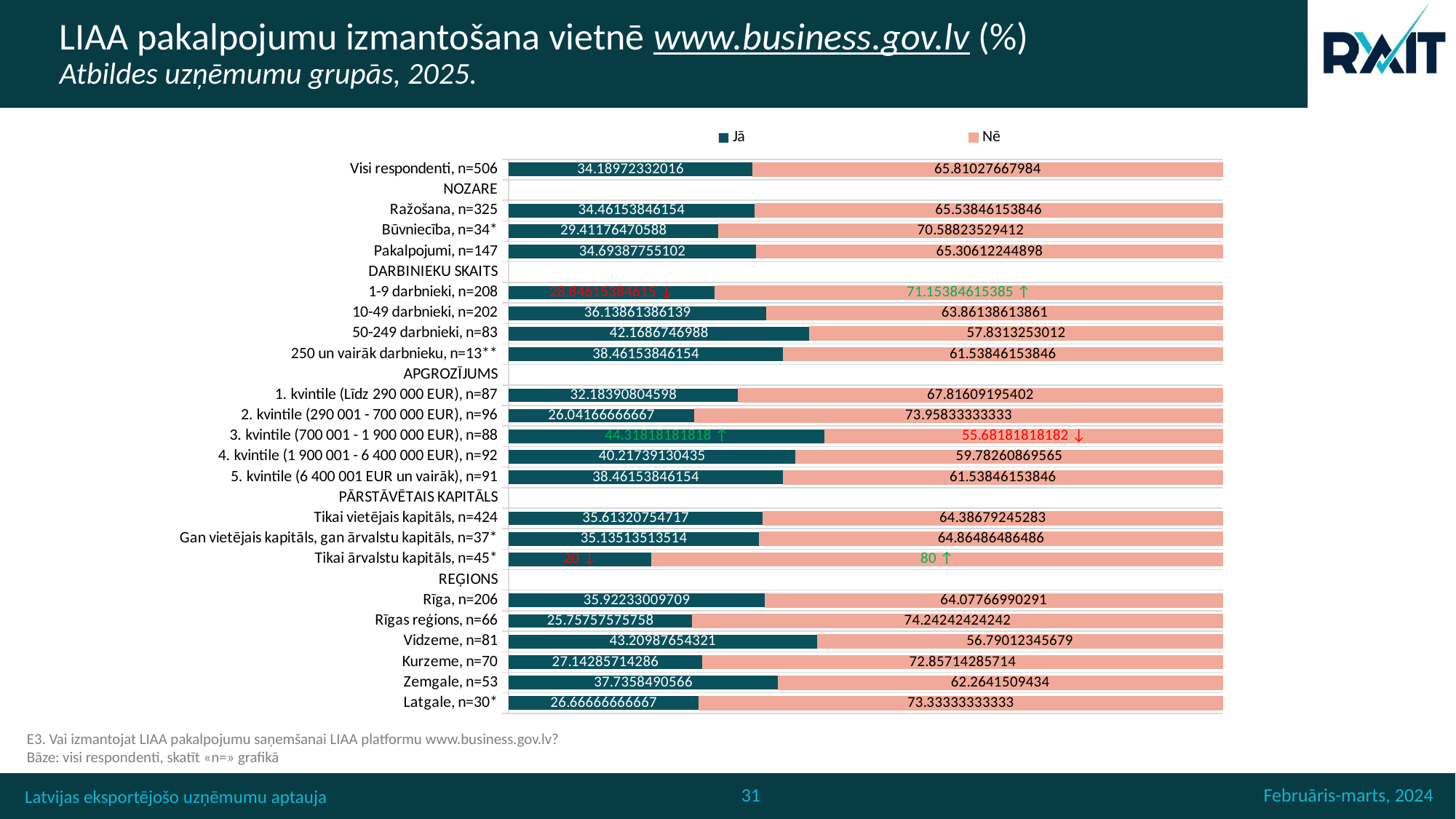
What is the total of the stacked bar for Tikai ārvalstu kapitāls, n=45*? 100 What are the two legend entries of the chart? Jā and Nē What is the Nē value for Būvniecība, n=34*? 70.58823529412 What is the Jā value for Visi respondenti, n=506? 34.18972332016 How many series does the legend list? 2 What is the Jā value for Vidzeme, n=81? 43.20987654321 What type of chart is shown on the slide? Stacked bar chart What is the difference between the Nē and Jā values for Tikai ārvalstu kapitāls, n=45*? 60 Which has a larger Jā value: Rīga, n=206 or Rīgas reģions, n=66? Rīga, n=206 What is the Nē value for 2. kvintile (290 001 - 700 000 EUR), n=96? 73.95833333333 Which group has the lowest Jā value? Tikai ārvalstu kapitāls, n=45* Which group has the highest Jā value? 3. kvintile (700 001 - 1 900 000 EUR), n=88